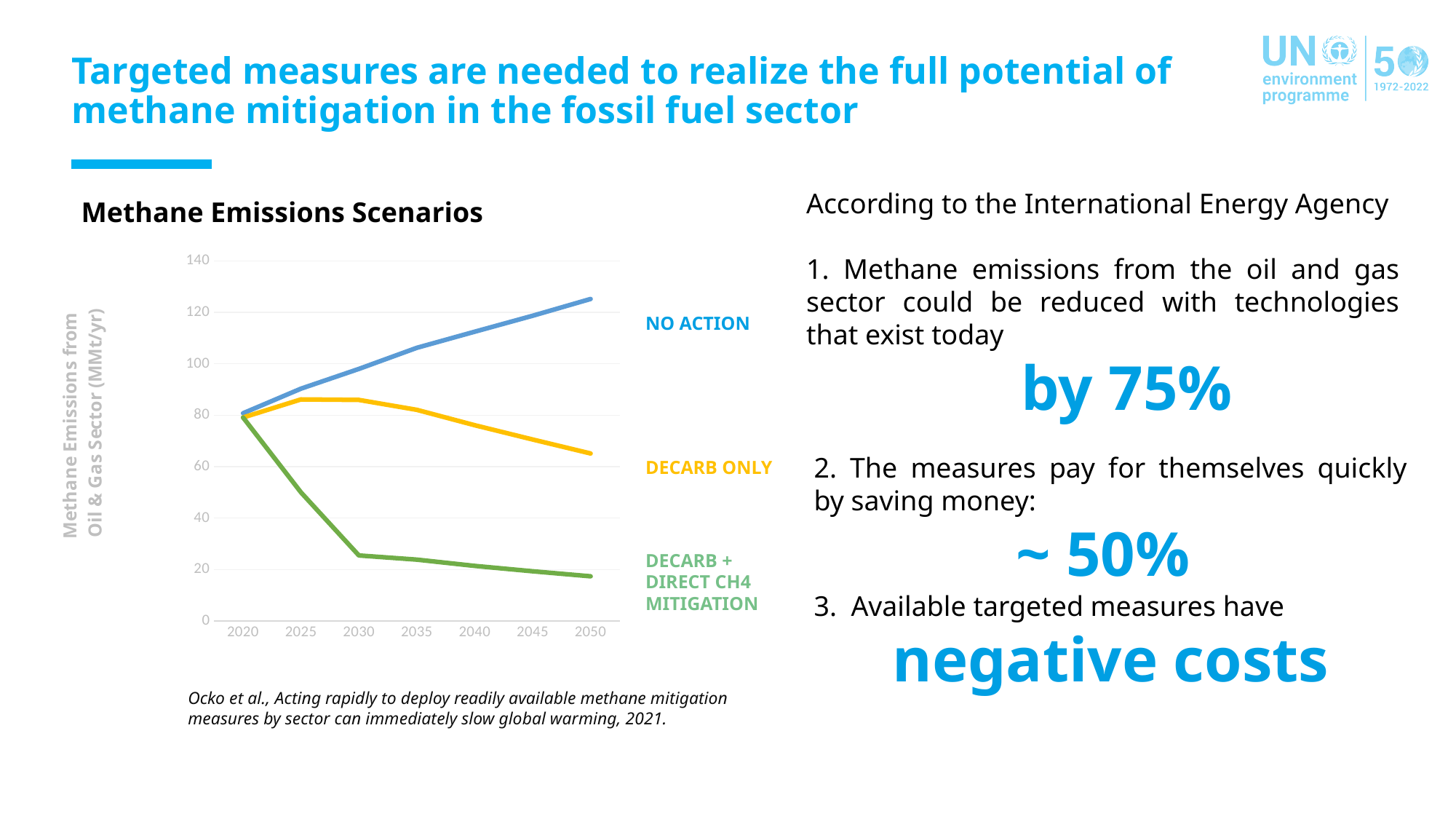
Does the NO ACTION line rise or fall from 2020 to 2050? rise Which scenario has the highest value in 2050? NO ACTION Is the value for DECARB ONLY in 2050 greater or less than 80? less What kind of chart is shown on the slide? line chart In 2050, which is larger: the DECARB ONLY value or the DECARB + DIRECT CH4 MITIGATION value? DECARB ONLY Is the value for DECARB + DIRECT CH4 MITIGATION in 2050 greater or less than 40? less How many year ticks are shown on the x axis of the chart? 7 What is the title of the chart? Methane Emissions Scenarios Which scenario has the lowest value in 2050? DECARB + DIRECT CH4 MITIGATION Does the DECARB + DIRECT CH4 MITIGATION line rise or fall from 2020 to 2050? fall How many scenario lines are plotted on the chart? 3 Is the value for NO ACTION in 2050 greater or less than 100? greater